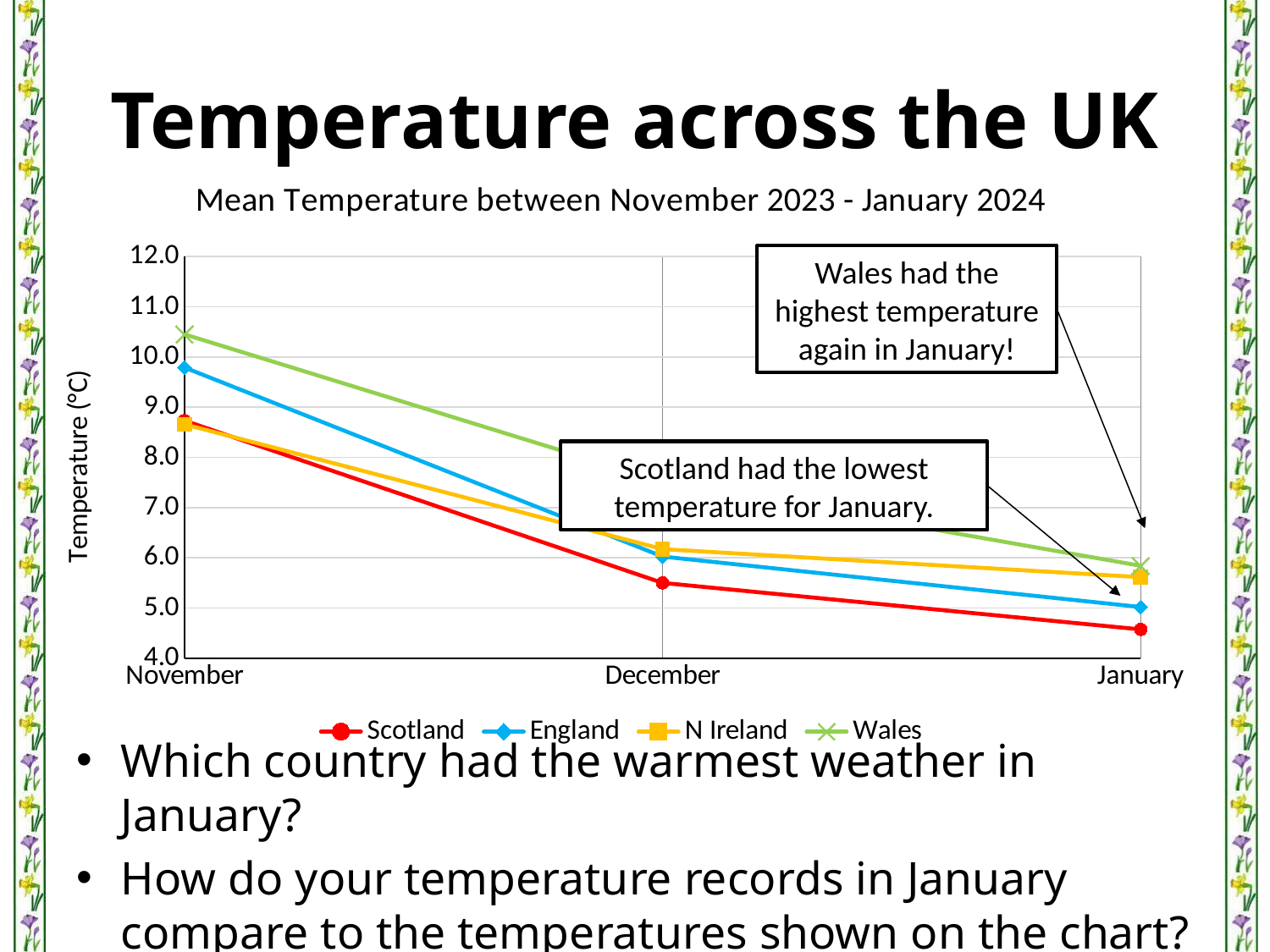
Which country had the lowest mean temperature in December? Scotland Do the temperatures rise or fall from November to January for every country? Fall Which country had the lowest mean temperature in January? Scotland Is the value for Scotland in January greater or less than 5.0? less How many months are plotted along the x axis? 3 In December, which is larger: the value for Wales or the value for England? Wales Which country had the highest mean temperature in January? Wales What kind of chart is shown on the slide? Line chart How many series does the legend list? 4 Is the value for Wales in November greater or less than 10.0? greater What is the title of the chart? Mean Temperature between November 2023 - January 2024 Which country had the highest mean temperature in November? Wales